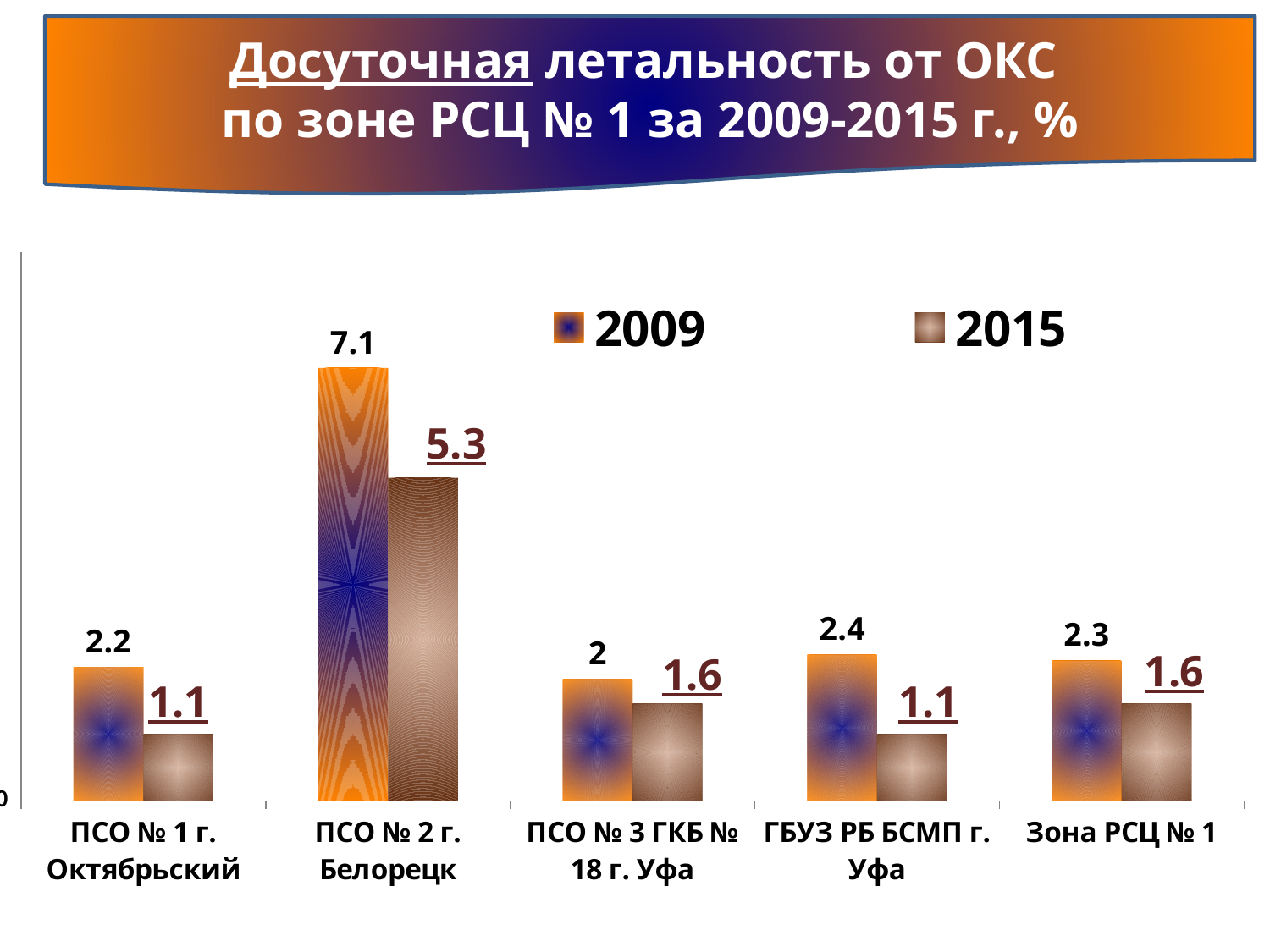
How many series does the legend list? 2 What kind of chart is shown on the slide? bar chart What is the 2009 value for ПСО № 2 г. Белорецк? 7.1 What is the 2015 value for ПСО № 1 г. Октябрьский? 1.1 What is the 2009 value for ГБУЗ РБ БСМП г. Уфа? 2.4 How many categories are shown on the x axis? 5 What are the two series named in the legend? 2009 and 2015 Which category has the lowest 2009 value? ПСО № 3 ГКБ № 18 г. Уфа What is the difference between the 2009 and 2015 values for ПСО № 2 г. Белорецк? 1.8 What is the 2015 value for Зона РСЦ № 1? 1.6 Which category has the highest 2015 value? ПСО № 2 г. Белорецк Which is larger: the 2015 value for ПСО № 3 ГКБ № 18 г. Уфа or the 2015 value for ГБУЗ РБ БСМП г. Уфа? ПСО № 3 ГКБ № 18 г. Уфа